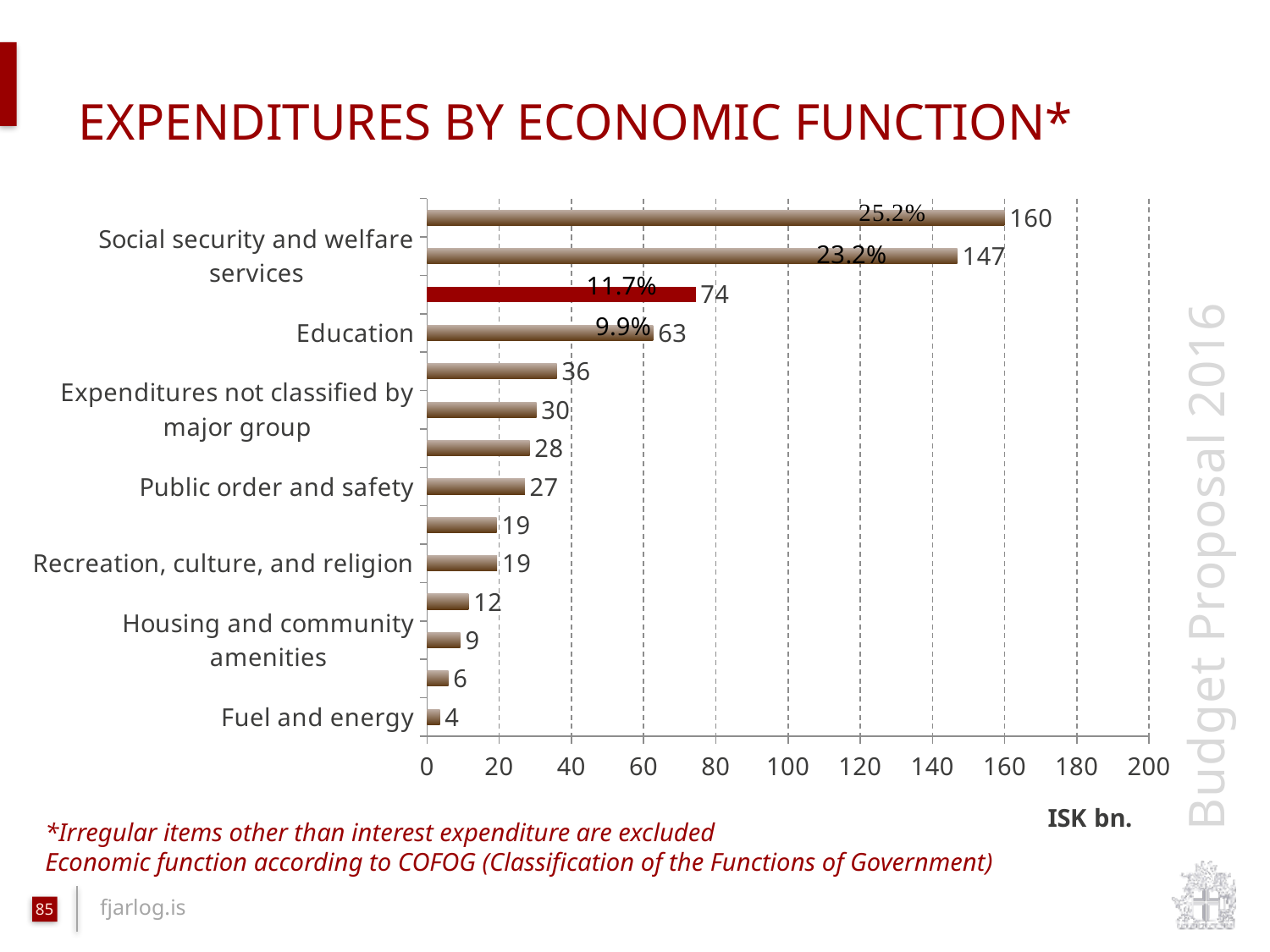
What is the value for Social security and welfare services? 147 What is the value for Housing and community amenities? 9 How many bars are plotted on the chart? 14 What is the largest value shown on the chart? 160 What kind of chart is shown on the slide? Bar chart Which labelled category has the lowest value? Fuel and energy What is the difference between the values for Education and Public order and safety? 36 What is the value for Public order and safety? 27 What is the value for Education? 63 Which is larger, the value for Expenditures not classified by major group or the value for Recreation, culture, and religion? Expenditures not classified by major group What is the value of the bar highlighted in dark red? 74 What is the value for Fuel and energy? 4